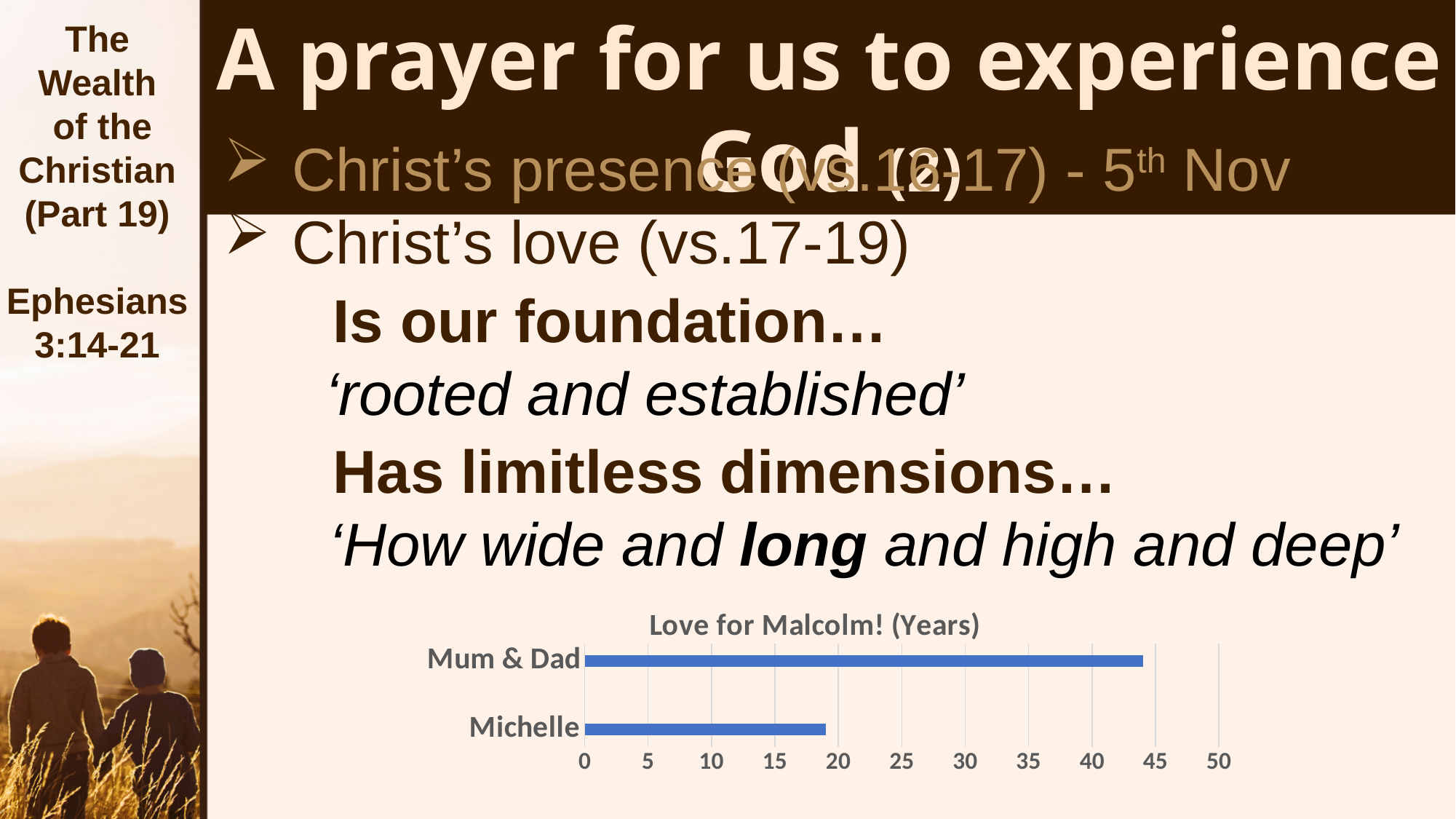
Is the value for Mum & Dad greater or less than 40? greater Which category has the lowest value in the chart? Michelle What kind of chart is shown on the slide? bar chart How many categories does the chart show? 2 Is the value for Mum & Dad greater or less than 50? less What is the title of the chart on the slide? Love for Malcolm! (Years) What is the maximum value shown on the chart's horizontal axis? 50 Which is larger in the chart, the value for Mum & Dad or the value for Michelle? Mum & Dad Is the value for Michelle greater or less than 25? less Which category has the highest value in the chart? Mum & Dad